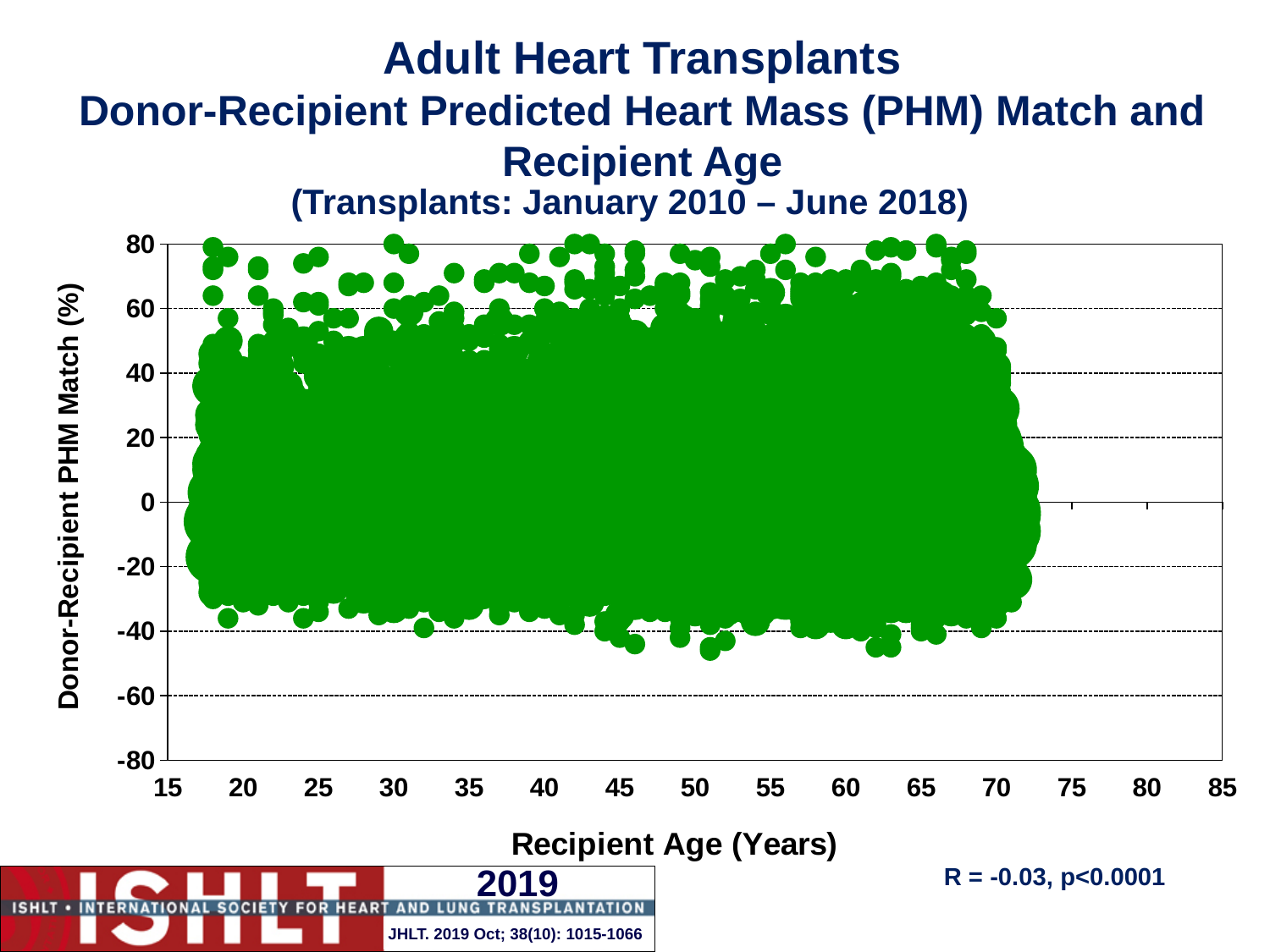
Is the lowest recipient age plotted greater or less than 20? less What kind of chart is shown on the slide? scatter plot Based on the R value shown, is the correlation between recipient age and PHM match positive or negative? negative Is the highest recipient age plotted greater or less than 75? less What is the label of the x axis? Recipient Age (Years) Is the lowest Donor-Recipient PHM Match value plotted greater or less than -60? greater What colour are the plotted points? green What correlation coefficient (R) is reported on the slide? -0.03 What p-value is reported on the slide? p<0.0001